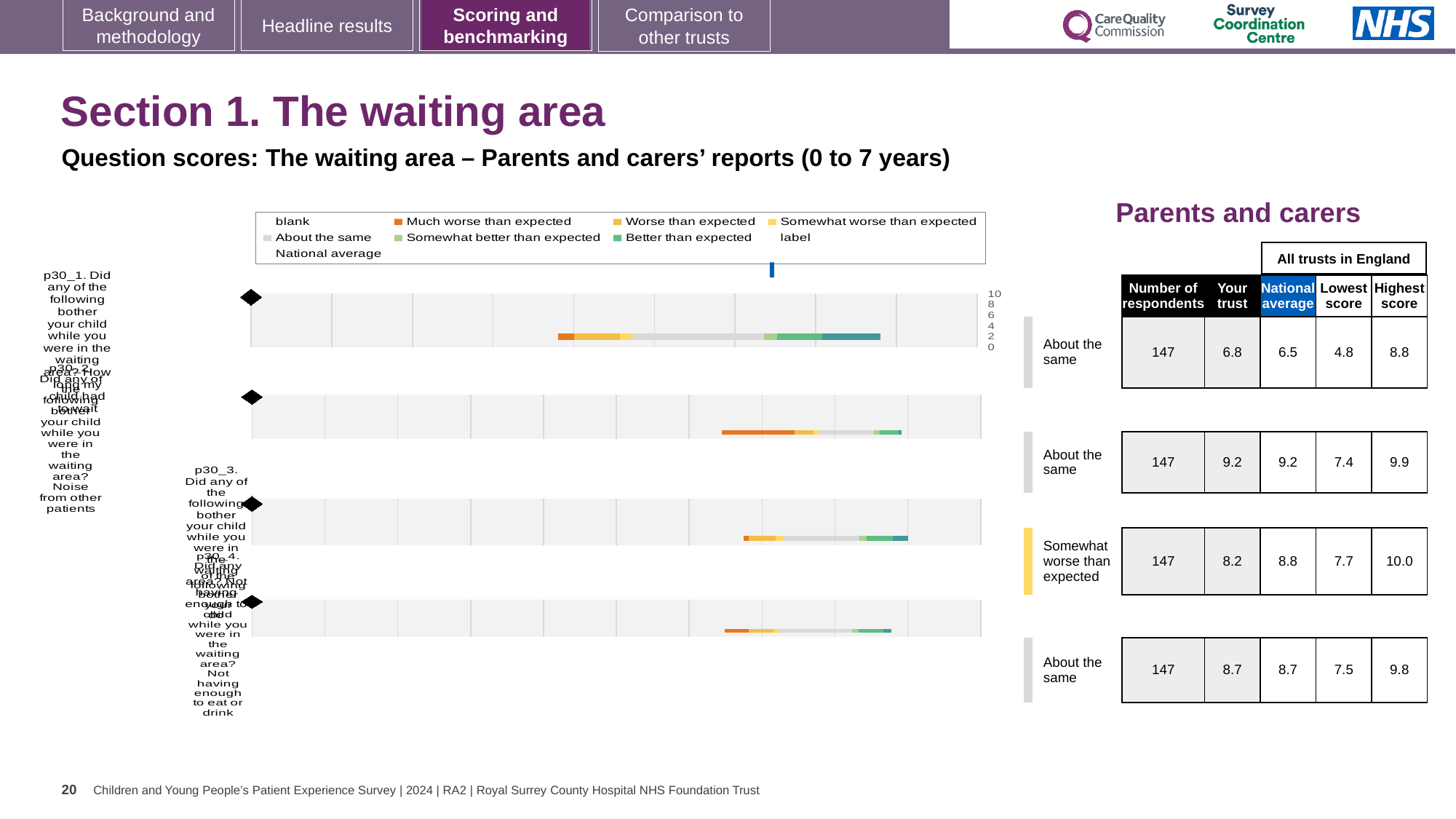
Which question row has the highest 'Your trust' score? the second row (how long my child had to wait), 9.2 Which question row has the lowest 'Your trust' score? the first row (noise from other patients), 6.8 What is the 'Your trust' score for the first question row (noise from other patients)? 6.8 What is the highest score across all trusts in England for the third question row (not having enough to do)? 10.0 How many respondents are listed for the fourth question row (not having enough to eat or drink)? 147 Which benchmark category is shown for the third question row (not having enough to do)? Somewhat worse than expected What is the national average for the first question row (noise from other patients)? 6.5 What is the 'Your trust' score for the third question row (not having enough to do)? 8.2 What kind of chart is shown on the slide? bar chart For the third question row (not having enough to do), what is the difference between the national average and the 'Your trust' score? 0.6 How many question rows (bars) are plotted in the chart? 4 For the first question row (noise from other patients), is the 'Your trust' score or the national average larger? Your trust